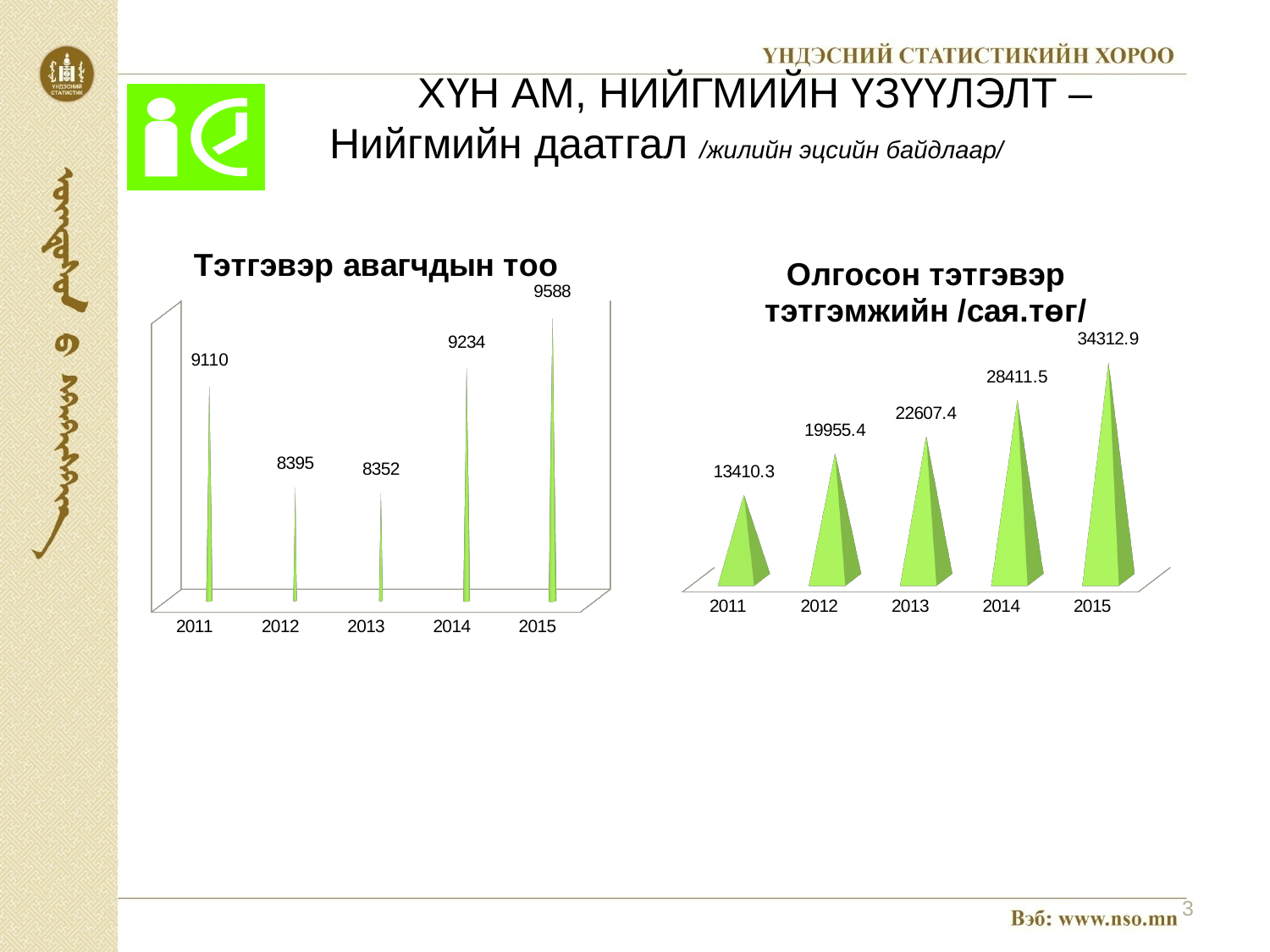
In the chart titled "Тэтгэвэр авагчдын тоо", how many years are shown on the x axis? 5 In the chart titled "Тэтгэвэр авагчдын тоо", which year has the lowest value? 2013 In the chart titled "Олгосон тэтгэвэр тэтгэмжийн /сая.төг/", do the values rise or fall from 2011 to 2015? rise In the chart titled "Тэтгэвэр авагчдын тоо", which year has the highest value? 2015 In the chart titled "Олгосон тэтгэвэр тэтгэмжийн /сая.төг/", what is the difference between the values for 2014 and 2013? 5804.1 In the chart titled "Олгосон тэтгэвэр тэтгэмжийн /сая.төг/", what is the value for 2012? 19955.4 In the chart titled "Олгосон тэтгэвэр тэтгэмжийн /сая.төг/", what is the value for 2015? 34312.9 In the chart titled "Тэтгэвэр авагчдын тоо", what is the difference between the values for 2015 and 2011? 478 In the chart titled "Тэтгэвэр авагчдын тоо", what is the value for 2013? 8352 In the chart titled "Тэтгэвэр авагчдын тоо", which is larger, the value for 2012 or the value for 2014? 2014 What kind of chart is the chart titled "Олгосон тэтгэвэр тэтгэмжийн /сая.төг/"? bar chart In the chart titled "Олгосон тэтгэвэр тэтгэмжийн /сая.төг/", which year has the lowest value? 2011